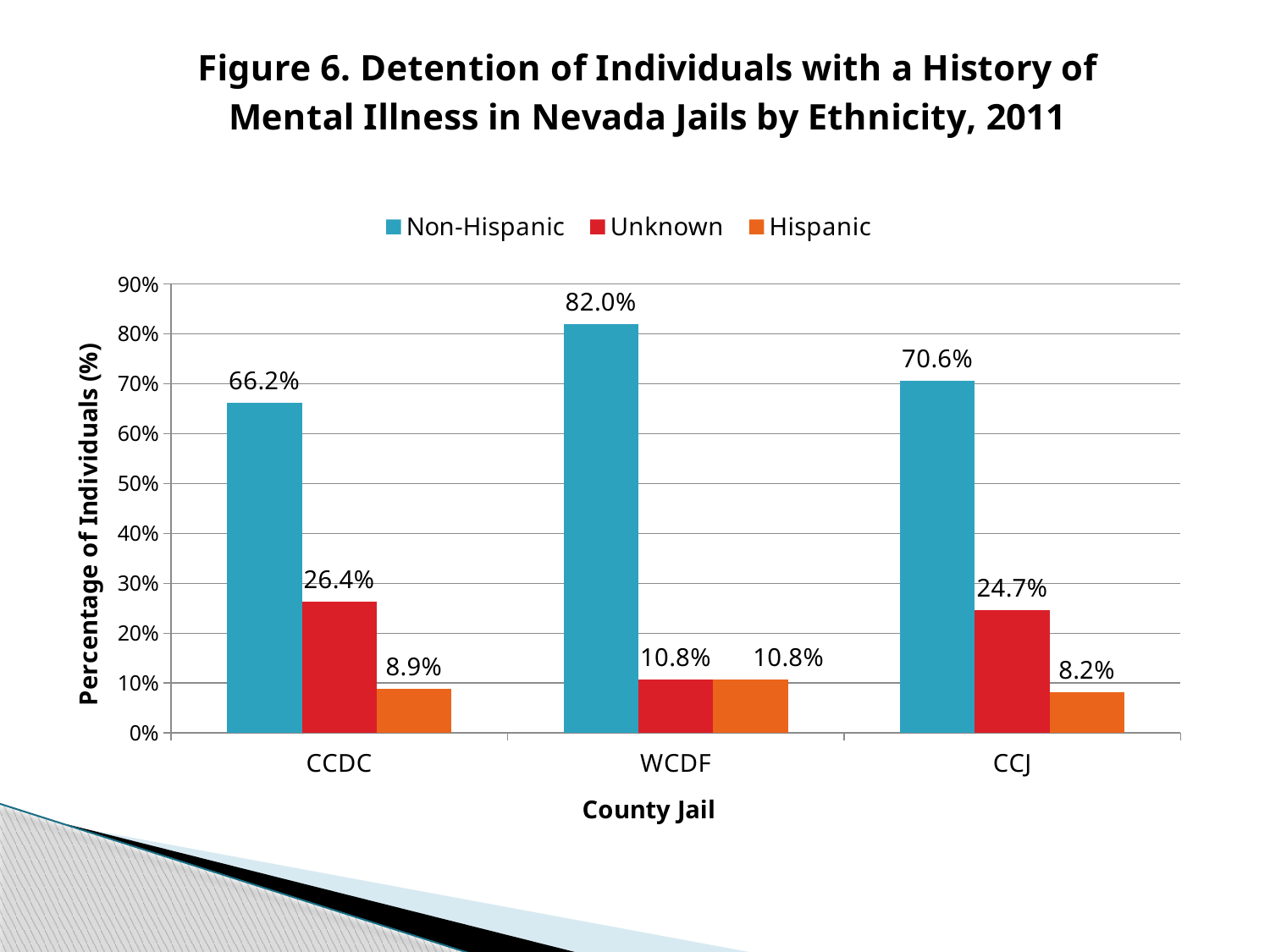
Which is larger, the Unknown percentage for CCDC or for CCJ? CCDC How many series does the legend list? 3 What is the Non-Hispanic percentage for WCDF? 82.0% Which county jail has the lowest Hispanic percentage? CCJ What is the label of the y axis? Percentage of Individuals (%) Which county jail has the highest Non-Hispanic percentage? WCDF What is the Unknown percentage for CCDC? 26.4% How many county jails are shown on the x axis? 3 What is the Hispanic percentage for CCJ? 8.2% Is the Non-Hispanic value for CCJ greater or less than 60%? greater What kind of chart is shown? Bar chart What is the difference between the Non-Hispanic percentages for WCDF and CCDC? 15.8%